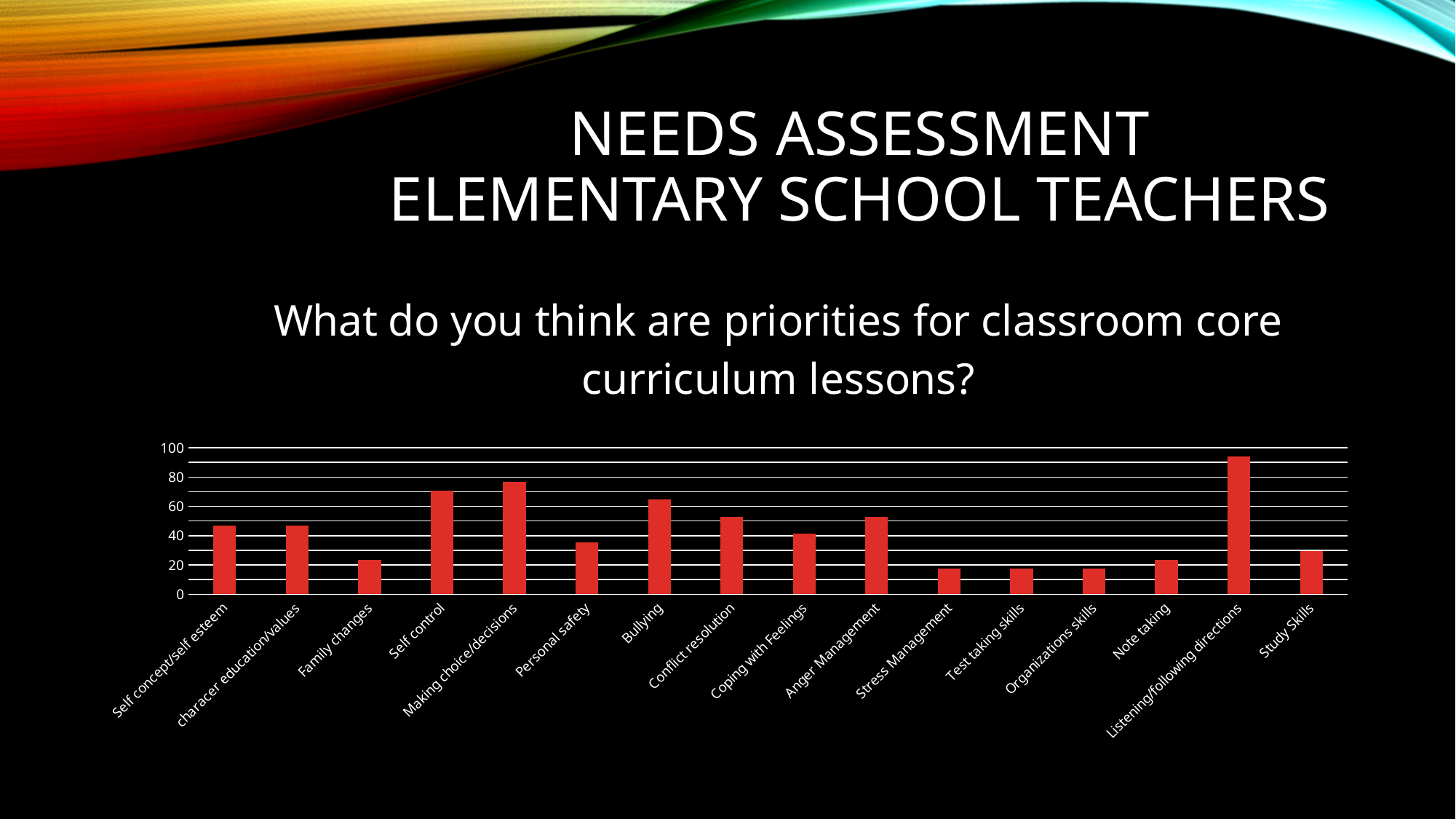
What is the highest value shown on the vertical axis of the chart? 100 How many categories are shown on the x axis of the chart? 16 Is the value for Listening/following directions greater or less than 80? greater What kind of chart is shown on the slide? bar chart Is the value for Making choice/decisions greater or less than 60? greater Is the value for Family changes greater or less than 40? less Which has a larger value, Making choice/decisions or Bullying? Making choice/decisions Which category has the highest value in the chart? Listening/following directions Which has a larger value, Listening/following directions or Self control? Listening/following directions Which has a larger value, Personal safety or Family changes? Personal safety